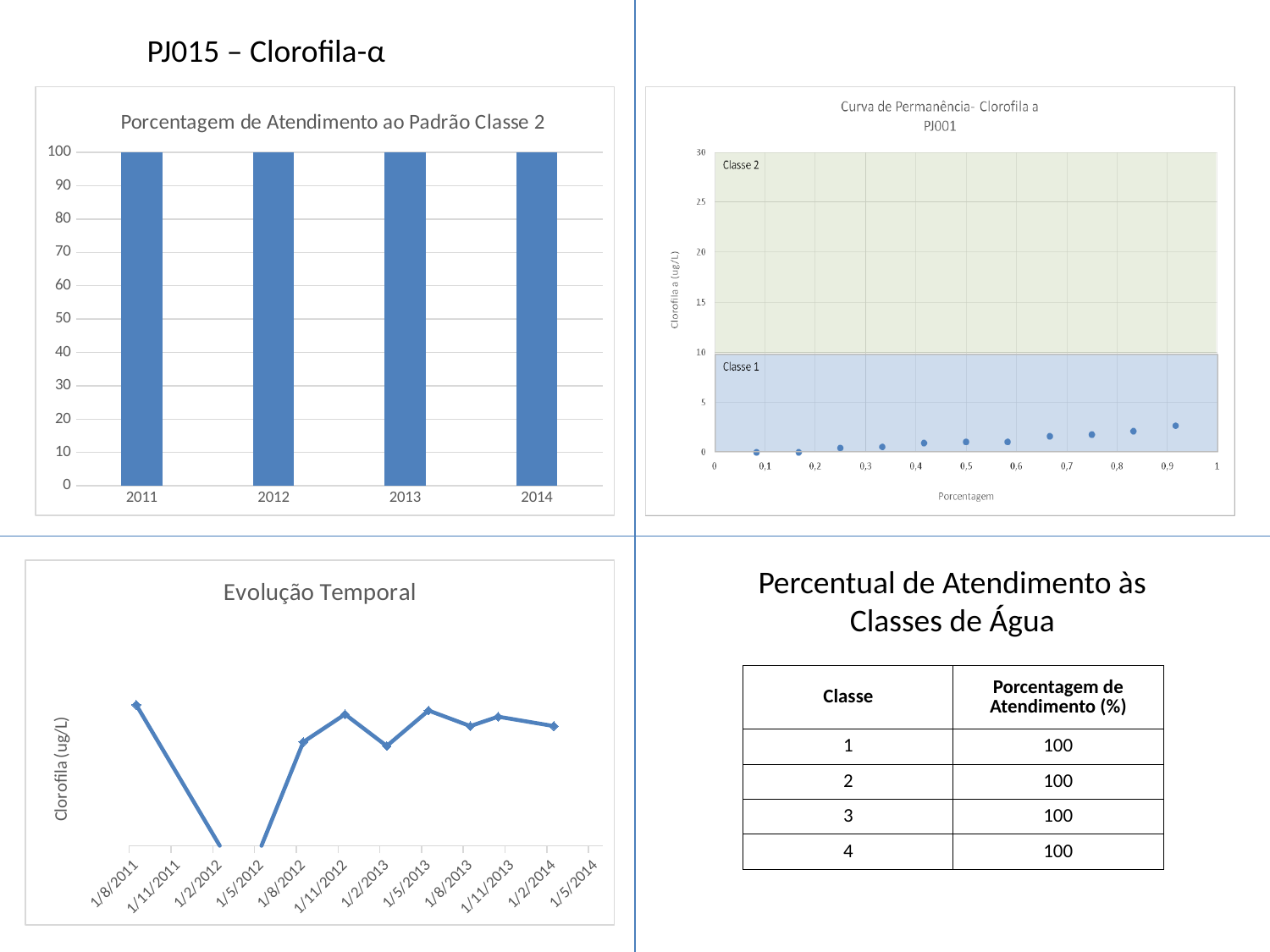
In the chart titled "Porcentagem de Atendimento ao Padrão Classe 2", what is the value for 2013? 100 In the chart titled "Evolução Temporal", what is the label of the y axis? Clorofila (ug/L) In the chart titled "Evolução Temporal", which is larger, the value at 1/8/2011 or the value at 1/2/2012? 1/8/2011 What kind of chart is the one titled "Evolução Temporal"? line chart In the chart titled "Porcentagem de Atendimento ao Padrão Classe 2", is the value for 2012 greater or less than 50? greater In the chart titled "Porcentagem de Atendimento ao Padrão Classe 2", what is the difference between the values for 2012 and 2014? 0 In the chart titled "Curva de Permanência - Clorofila a PJ001", what is the label of the x axis? Porcentagem In the chart titled "Curva de Permanência - Clorofila a PJ001", do the plotted values rise or fall as Porcentagem increases? rise In the chart titled "Porcentagem de Atendimento ao Padrão Classe 2", what is the value for 2011? 100 What kind of chart is the one titled "Porcentagem de Atendimento ao Padrão Classe 2"? bar chart In the chart titled "Curva de Permanência - Clorofila a PJ001", is the value at Porcentagem 0,9 greater or less than 10? less In the chart titled "Porcentagem de Atendimento ao Padrão Classe 2", how many years are shown on the x axis? 4